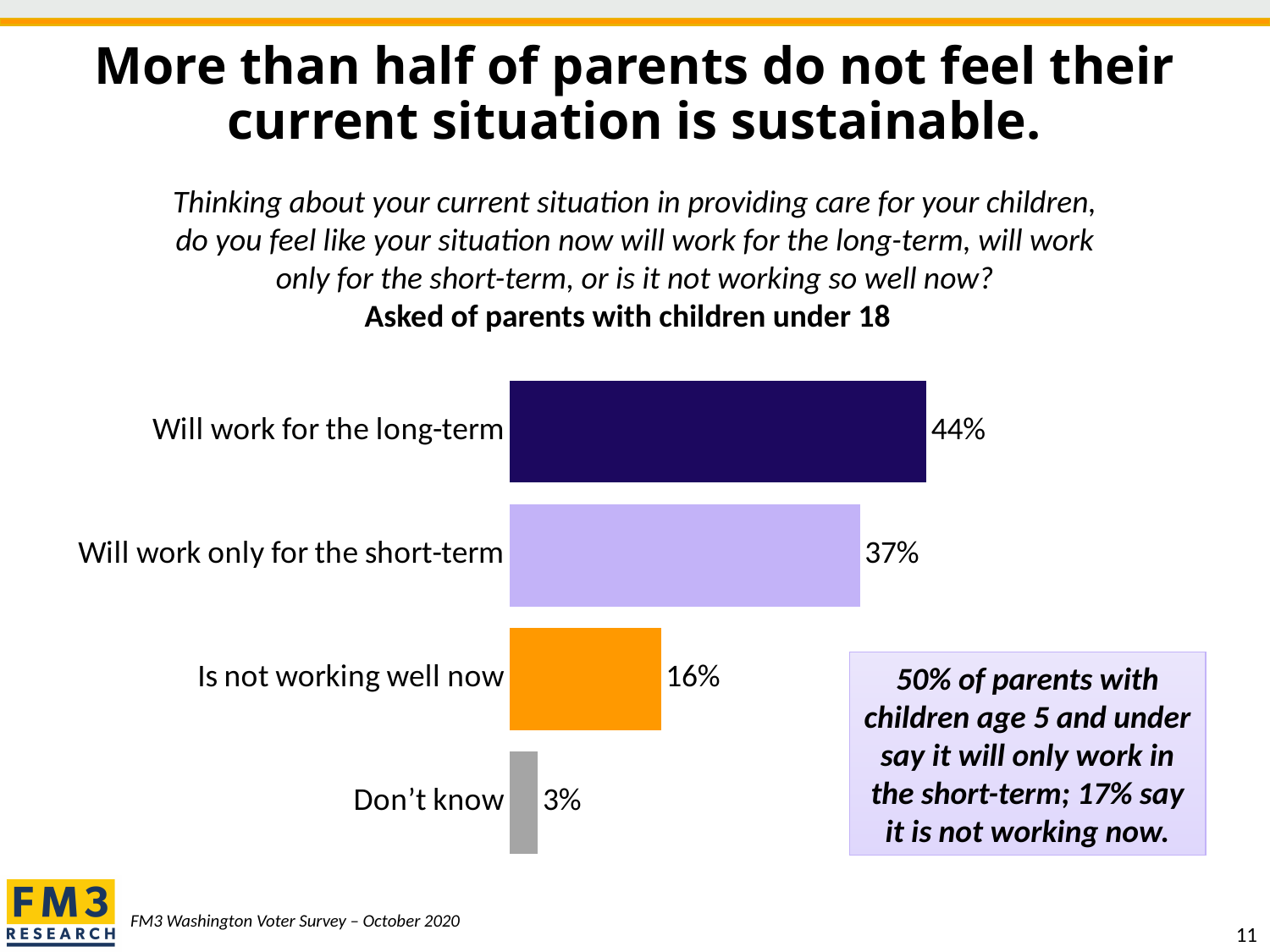
Which is larger: the value for "Is not working well now" or the value for "Don't know"? Is not working well now What kind of chart is shown on the slide? Bar chart Which response category has the lowest value? Don't know What percentage of parents answered "Don't know"? 3% What percentage of parents say their situation will work only for the short-term? 37% Which response category has the highest value? Will work for the long-term What percentage of parents say their situation is not working well now? 16% What colour is the bar for "Is not working well now"? Orange What is the difference between the "Will work for the long-term" and "Will work only for the short-term" values? 7 percentage points What is the difference between the "Will work only for the short-term" and "Is not working well now" values? 21 percentage points What percentage of parents say their situation will work for the long-term? 44% How many response categories are shown in the chart? 4